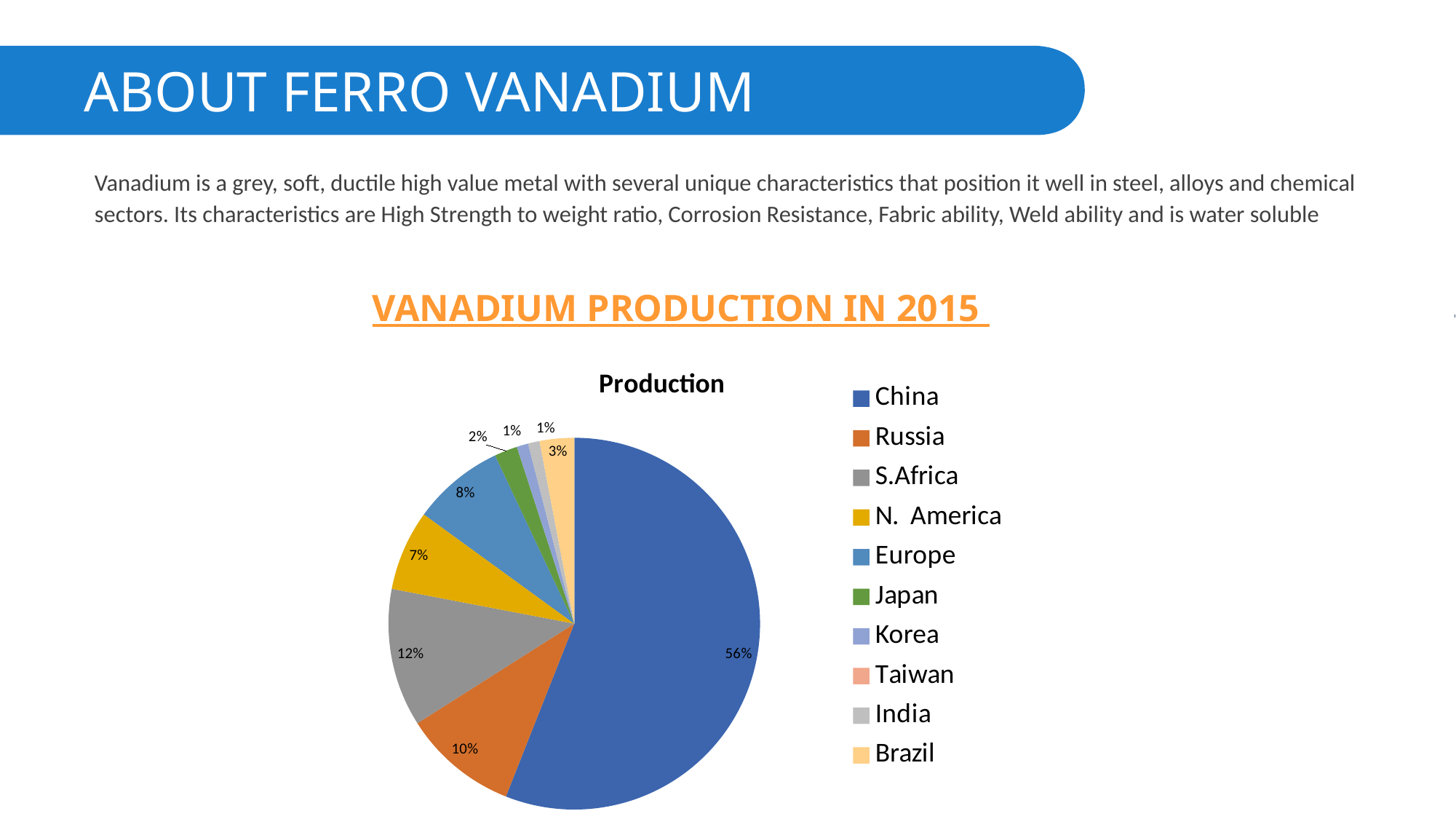
What is the share shown for N. America? 7% What is the share shown for Japan in the pie chart? 2% What share of vanadium production does China have in the pie chart? 56% What is the share for S.Africa in the pie chart? 12% Which country has the largest slice of the pie chart? China How many countries or regions are listed in the chart legend? 10 What percentage of production is attributed to Brazil? 3% How many percentage points larger is S.Africa's share than Russia's? 2% What percentage does Europe account for in the pie chart? 8% What kind of chart is shown on the slide? pie chart What percentage of production is attributed to Russia? 10% Which has a larger share of production, Europe or N. America? Europe